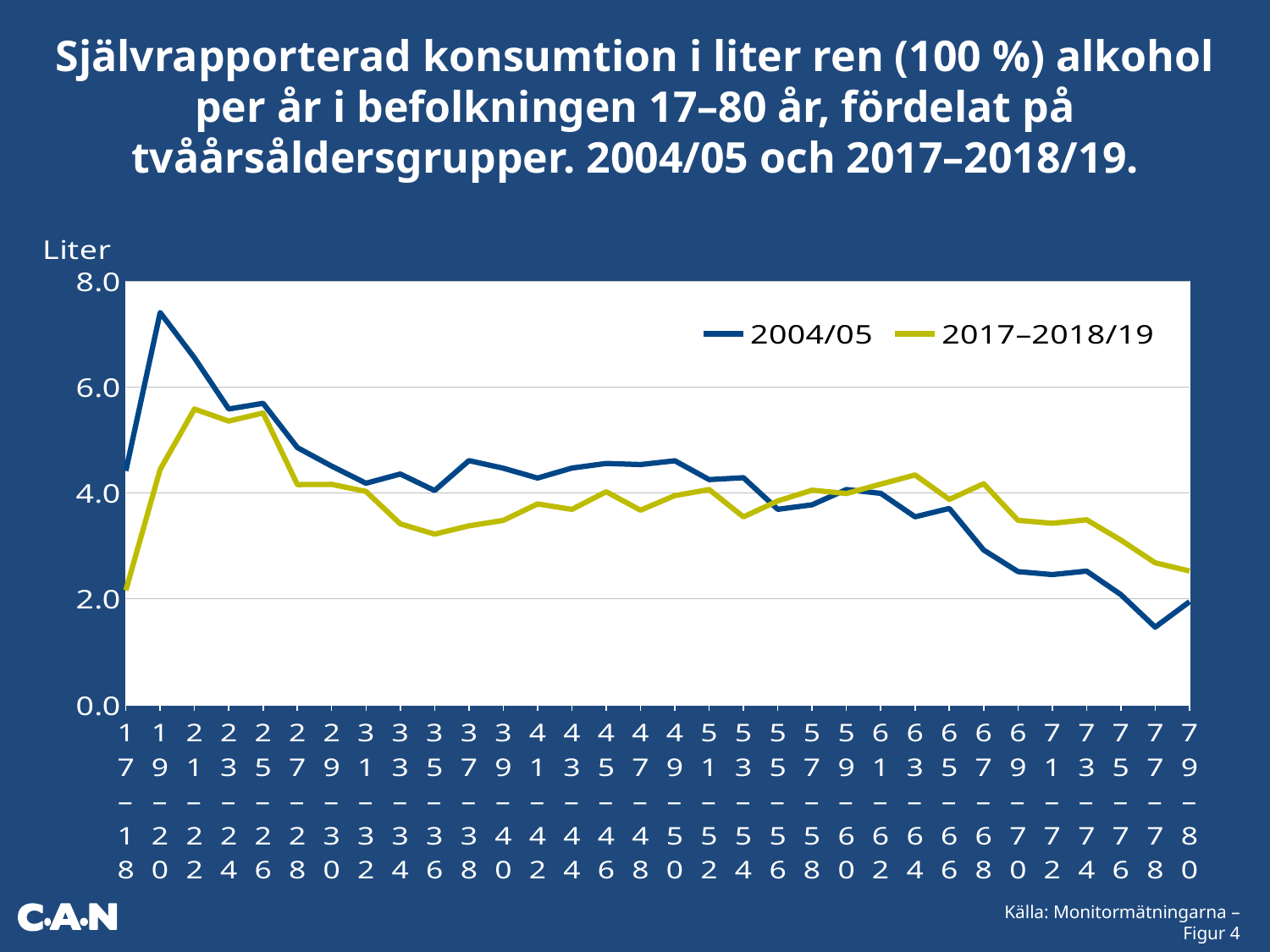
What is the label on the vertical axis? Liter Is the 2017–2018/19 value for the 35–36 age group greater or less than 4.0? less What are the two series named in the legend? 2004/05 and 2017–2018/19 Does the 2004/05 series rise or fall from the 59–60 age group to the 77–78 age group? fall What kind of chart is shown on the slide? line chart How many series does the legend list? 2 Is the 2004/05 value for the 19–20 age group greater or less than 6.0? greater Which series has the higher value for the 75–76 age group, 2004/05 or 2017–2018/19? 2017–2018/19 For which age group is the 2017–2018/19 series lowest? 17–18 For which age group is the 2004/05 series highest? 19–20 How many two-year age groups are plotted along the x axis? 32 For which age group is the 2004/05 series lowest? 77–78